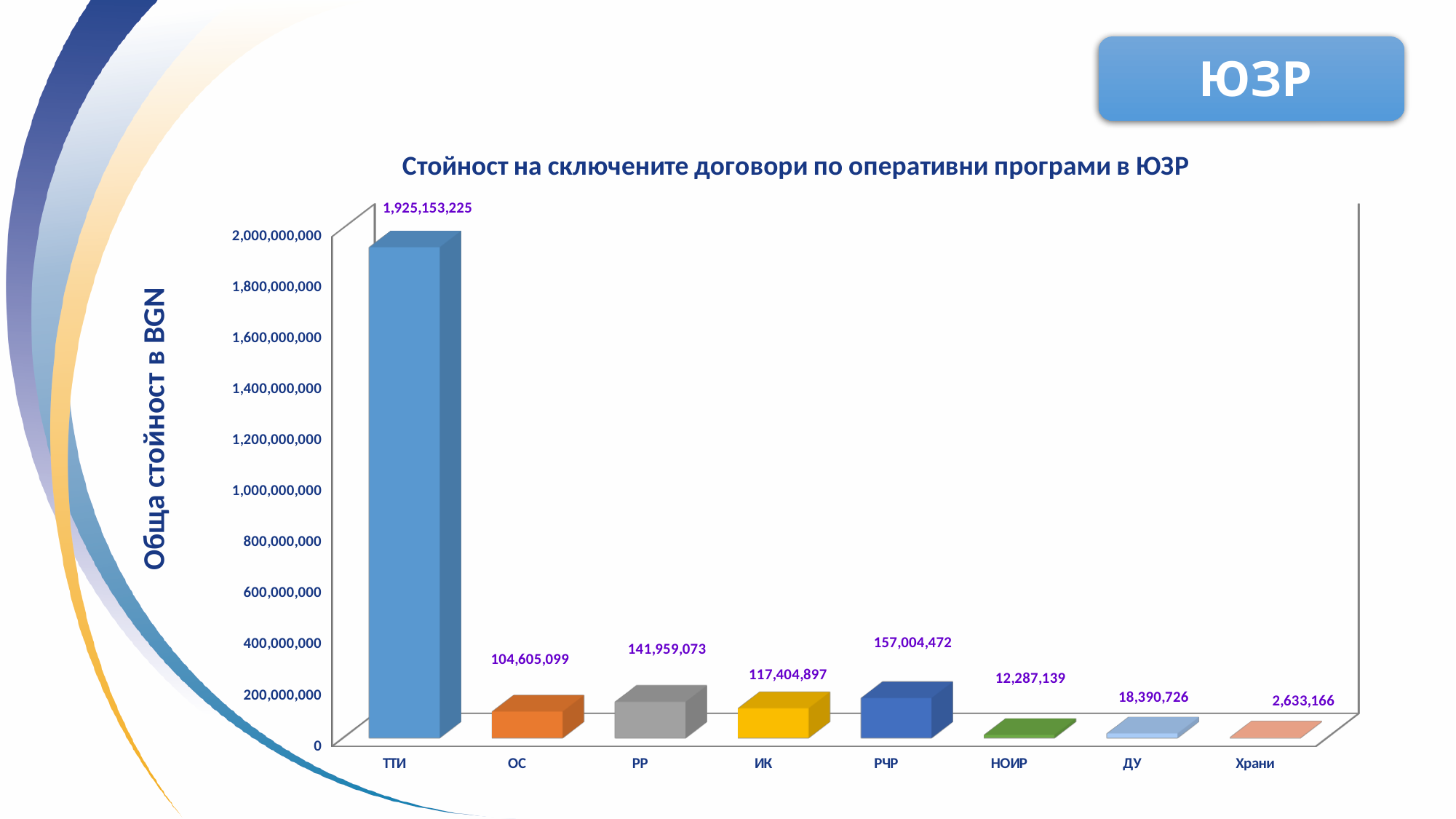
Is the value for ТТИ greater or less than 1,800,000,000? greater Which category has the lowest value? Храни What is the difference between the values for РЧР and РР? 15,045,399 What is the value for ТТИ? 1,925,153,225 Which is larger, the value for ОС or the value for ИК? ИК What is the value for РЧР? 157,004,472 What kind of chart is shown on the slide? bar chart Which category has the highest value? ТТИ How many categories are shown on the x axis? 8 What is the value for Храни? 2,633,166 What is the difference between the values for ДУ and НОИР? 6,103,587 What is the value for НОИР? 12,287,139